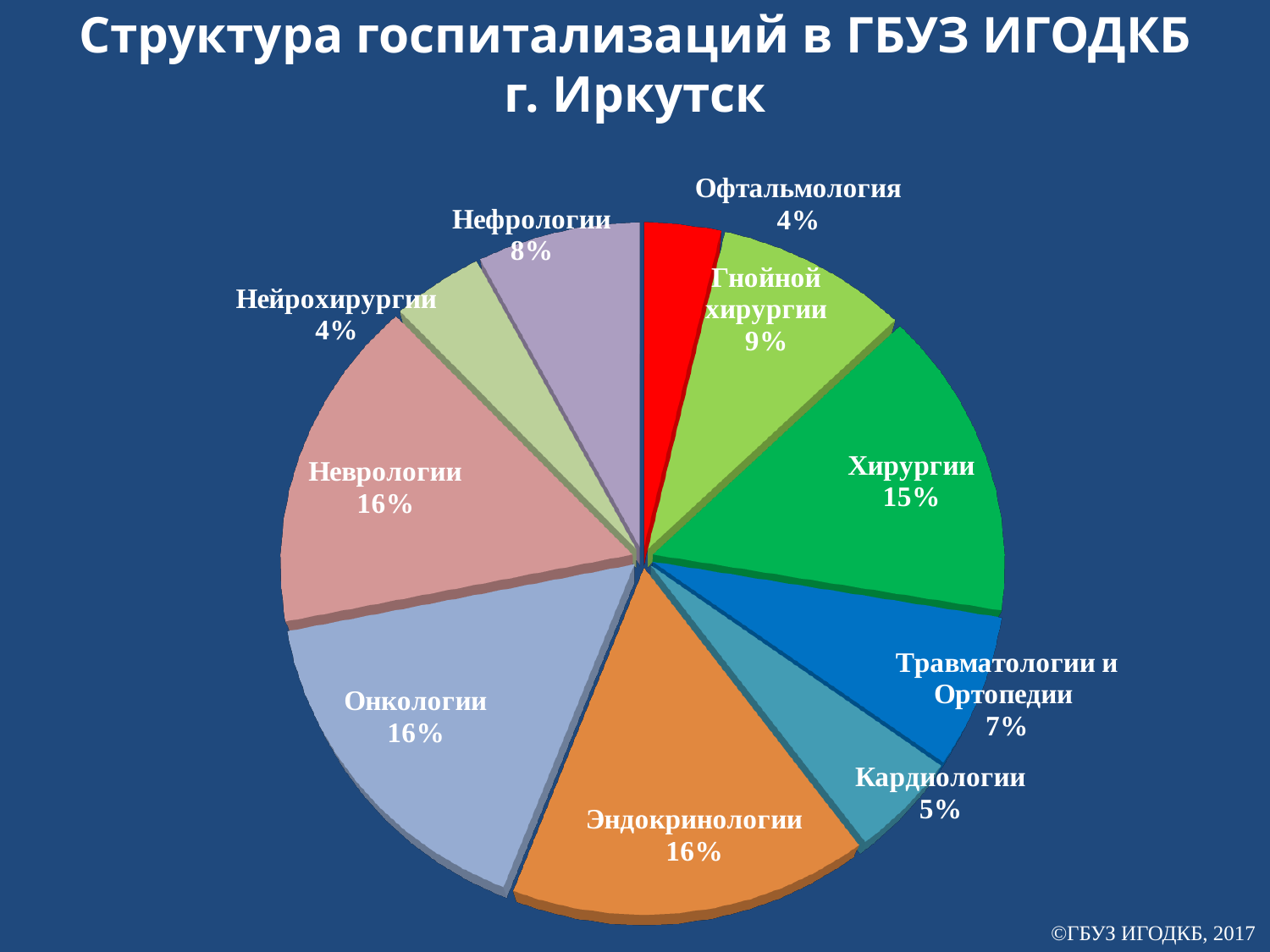
Which is larger, the share for Неврологии or the share for Нейрохирургии? Неврологии What is the difference between the shares for Онкологии and Нефрологии? 8% What percentage does the Эндокринологии slice show? 16% What share is shown for Нефрологии? 8% Which is larger, the share for Гнойной хирургии or the share for Травматологии и Ортопедии? Гнойной хирургии What is the title of the chart on the slide? Структура госпитализаций в ГБУЗ ИГОДКБ г. Иркутск What percentage is shown for Кардиологии? 5% What is the difference between the shares for Хирургии and Гнойной хирургии? 6% What kind of chart is shown on the slide? Pie chart How many slices does the pie chart have? 10 What is the value shown for Травматологии и Ортопедии? 7% What share of hospitalizations is for Хирургии? 15%